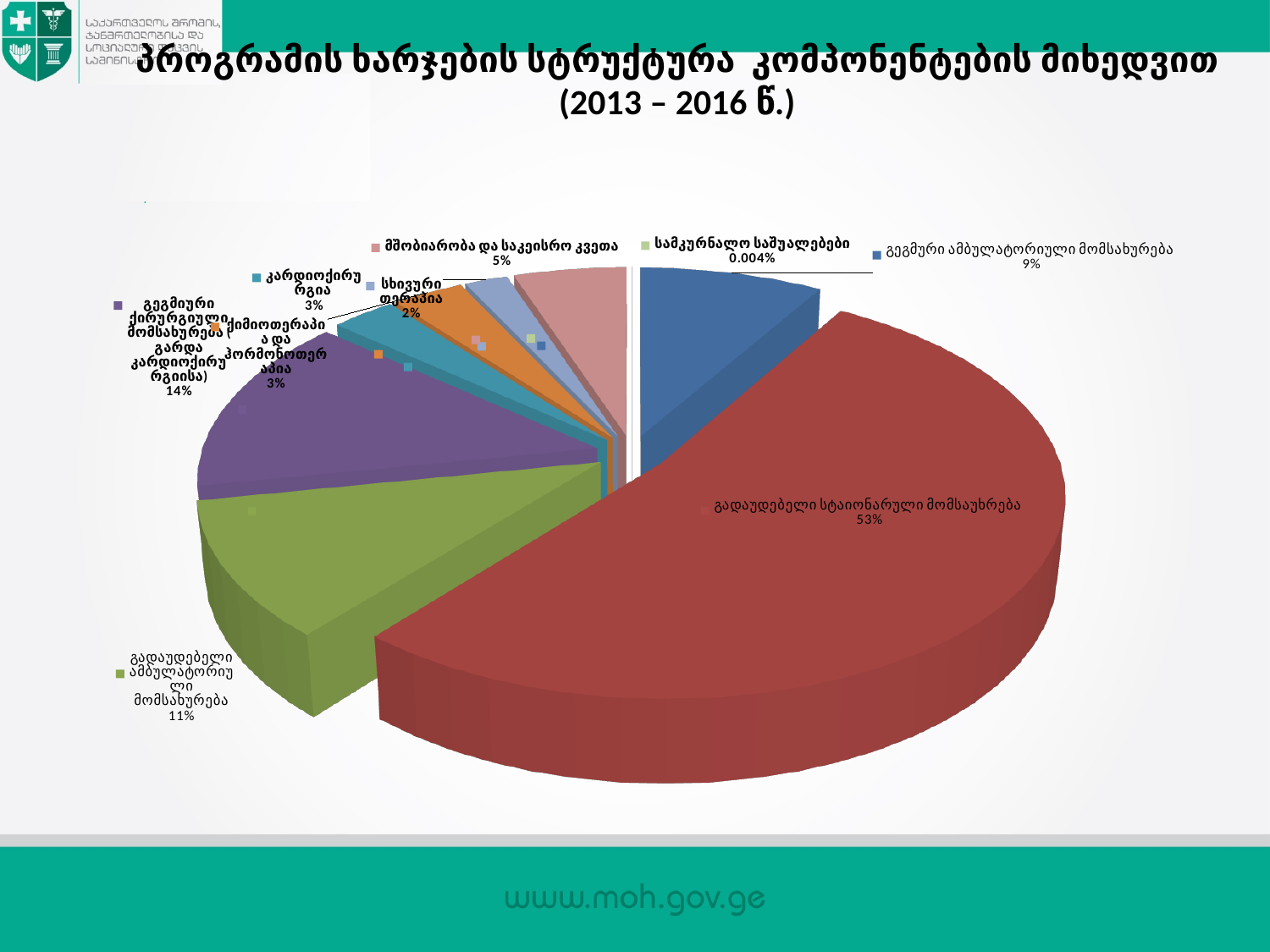
Which is larger: the share for გადაუდებელი ამბულატორიული მომსახურება or the share for გეგმიური ამბულატორიული მომსახურება? გადაუდებელი ამბულატორიული მომსახურება How many categories (slices) does the pie chart have? 9 What share of the pie is სამკურნალო საშუალებები? 0.004% What share of the pie is გეგმიური ამბულატორიული მომსახურება? 9% What share of the pie is გადაუდებელი სტაციონარული მომსახურება? 53% Which category has the smallest share of the pie? სამკურნალო საშუალებები What is the difference in percentage points between გადაუდებელი სტაციონარული მომსახურება and გეგმიური ქირურგიული მომსახურება (გარდა კარდიოქირურგიისა)? 39 What years does the chart title say the data covers? 2013 – 2016 What kind of chart is shown on the slide? pie chart Which category has the largest share of the pie? გადაუდებელი სტაციონარული მომსახურება